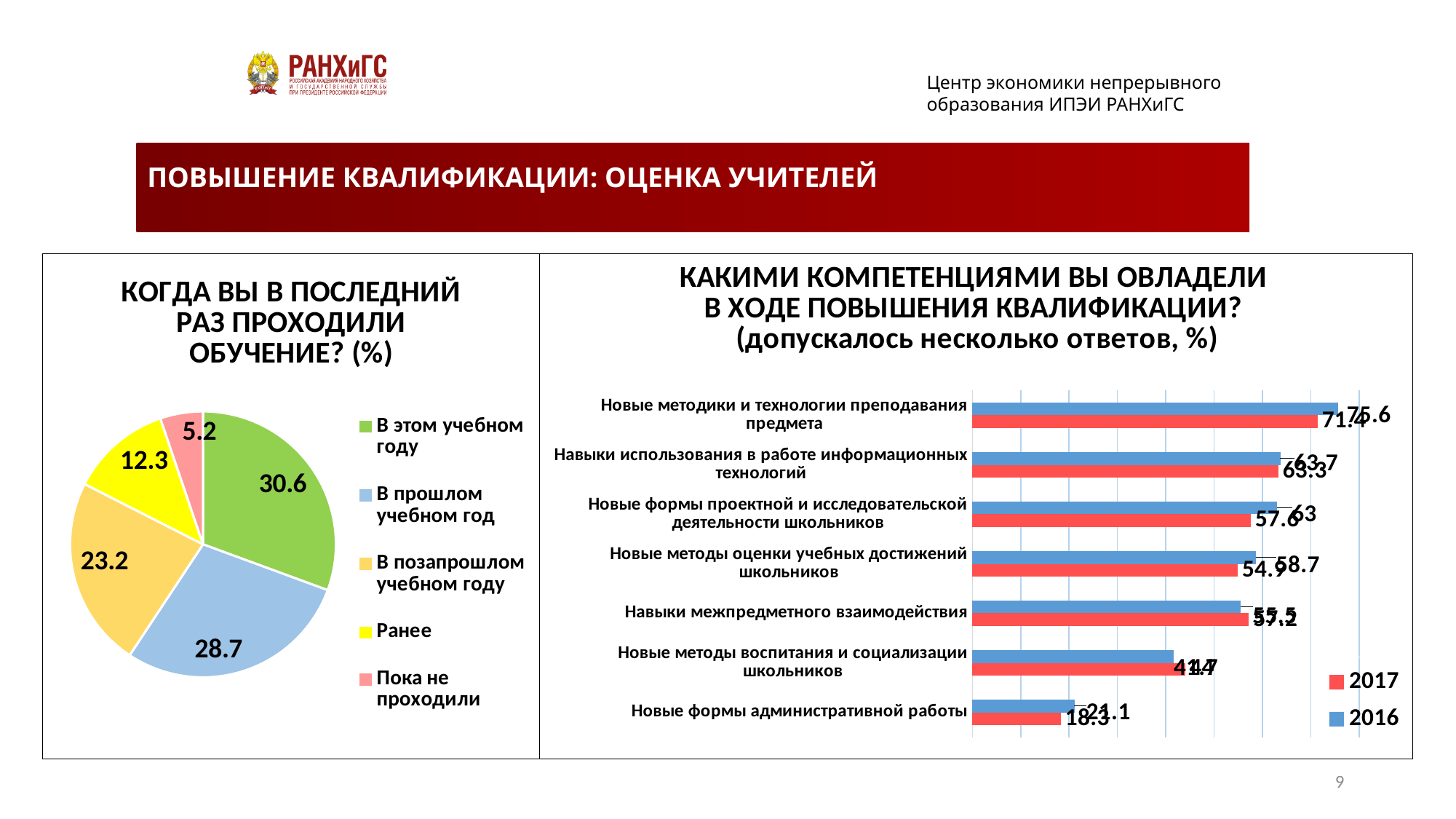
On the pie chart on the left, what share is shown for "В этом учебном году"? 30.6 On the pie chart on the left, which category has the largest slice? В этом учебном году On the pie chart on the left, what share is shown for "Пока не проходили"? 5.2 On the bar chart on the right, what is the 2017 value for "Новые формы административной работы"? 18.3 On the pie chart on the left, which category has the smallest slice? Пока не проходили On the bar chart on the right, what is the 2016 value for "Новые методики и технологии преподавания предмета"? 75.6 How many slices does the pie chart on the left have? 5 On the bar chart on the right, for "Новые формы проектной и исследовательской деятельности школьников", which year has the larger value, 2016 or 2017? 2016 How many series does the legend of the bar chart on the right list? 2 What type of chart is the chart on the right of the slide? Bar chart On the bar chart on the right, which competency has the lowest values in both years? Новые формы административной работы On the pie chart on the left, what is the difference between the values for "В прошлом учебном год" and "Ранее"? 16.4